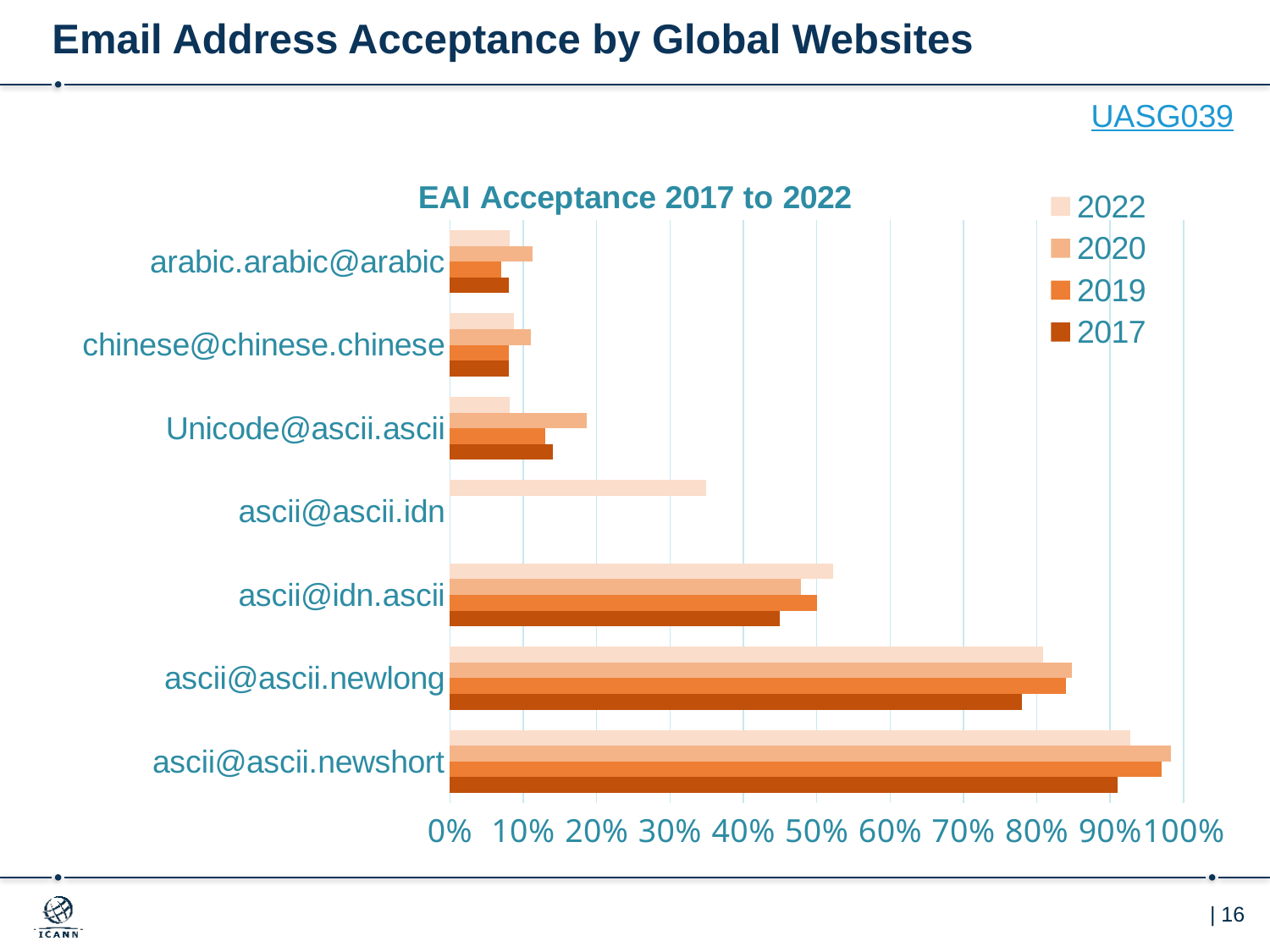
Is the 2022 value for arabic.arabic@arabic greater or less than 10%? less Is the 2017 value for ascii@idn.ascii greater or less than 50%? less What kind of chart is shown on the slide? bar chart Is the 2022 value for ascii@ascii.newshort greater or less than 90%? greater Which years are listed in the chart legend? 2022, 2020, 2019, 2017 How many series does the legend list? 4 Which email address category has the highest acceptance values? ascii@ascii.newshort For 2022, which is larger: the value for ascii@ascii.newlong or the value for ascii@idn.ascii? ascii@ascii.newlong How many email address categories are shown on the chart? 7 What is the title of the chart? EAI Acceptance 2017 to 2022